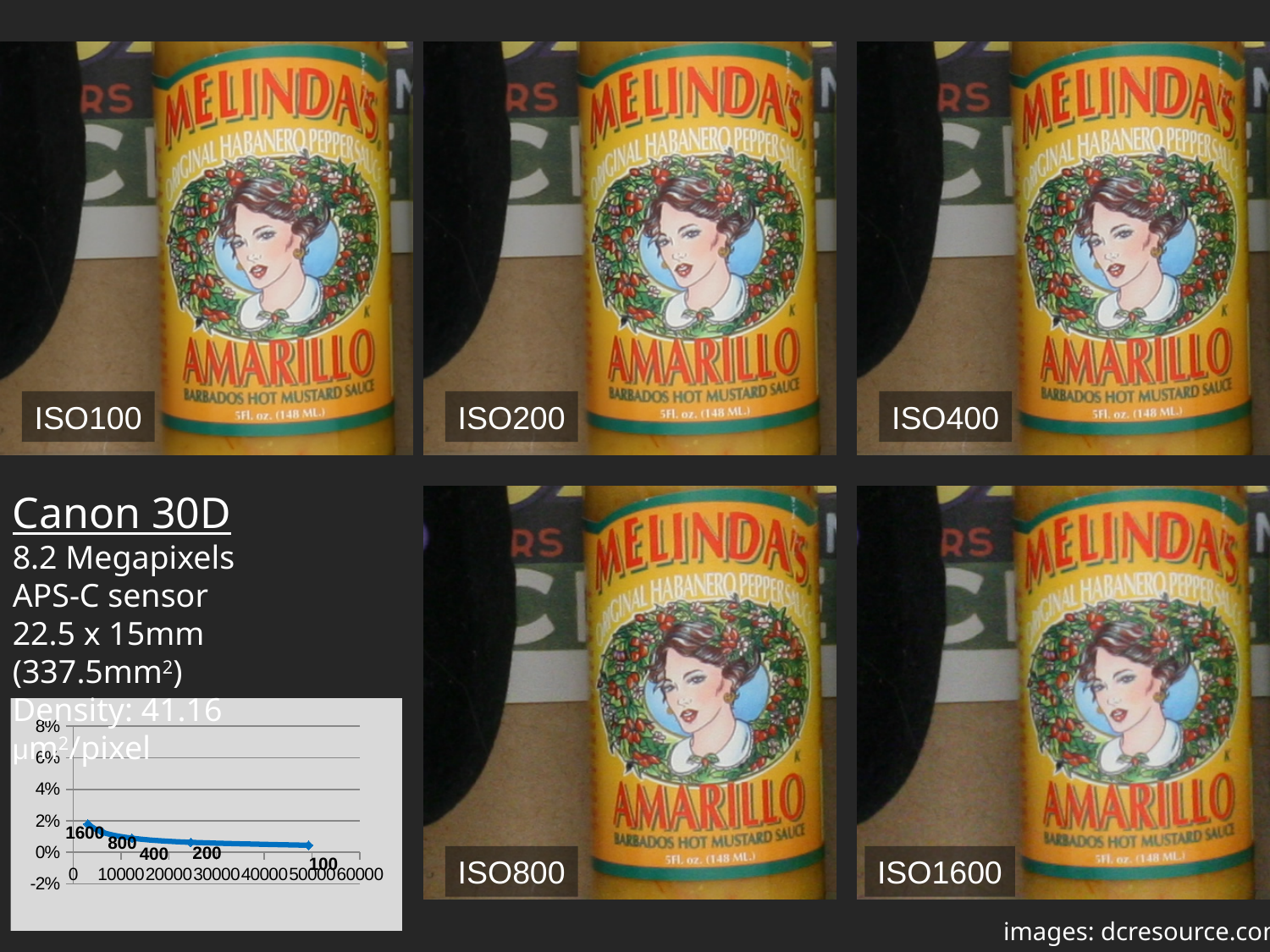
Is the value for the point labelled 400 greater or less than 4%? less Which labelled point on the chart has the highest value? 1600 What is the highest value shown on the chart's x axis? 60000 Which has the larger value on the chart, the point labelled 1600 or the point labelled 100? 1600 What kind of chart is shown on the slide? line chart Is the value for the point labelled 100 greater or less than 2%? less What is the highest value shown on the chart's y axis? 8% Do the plotted values rise or fall as you move from left to right along the x axis? fall How many data points are labelled on the chart? 5 Is the value for the point labelled 1600 greater or less than 0%? greater